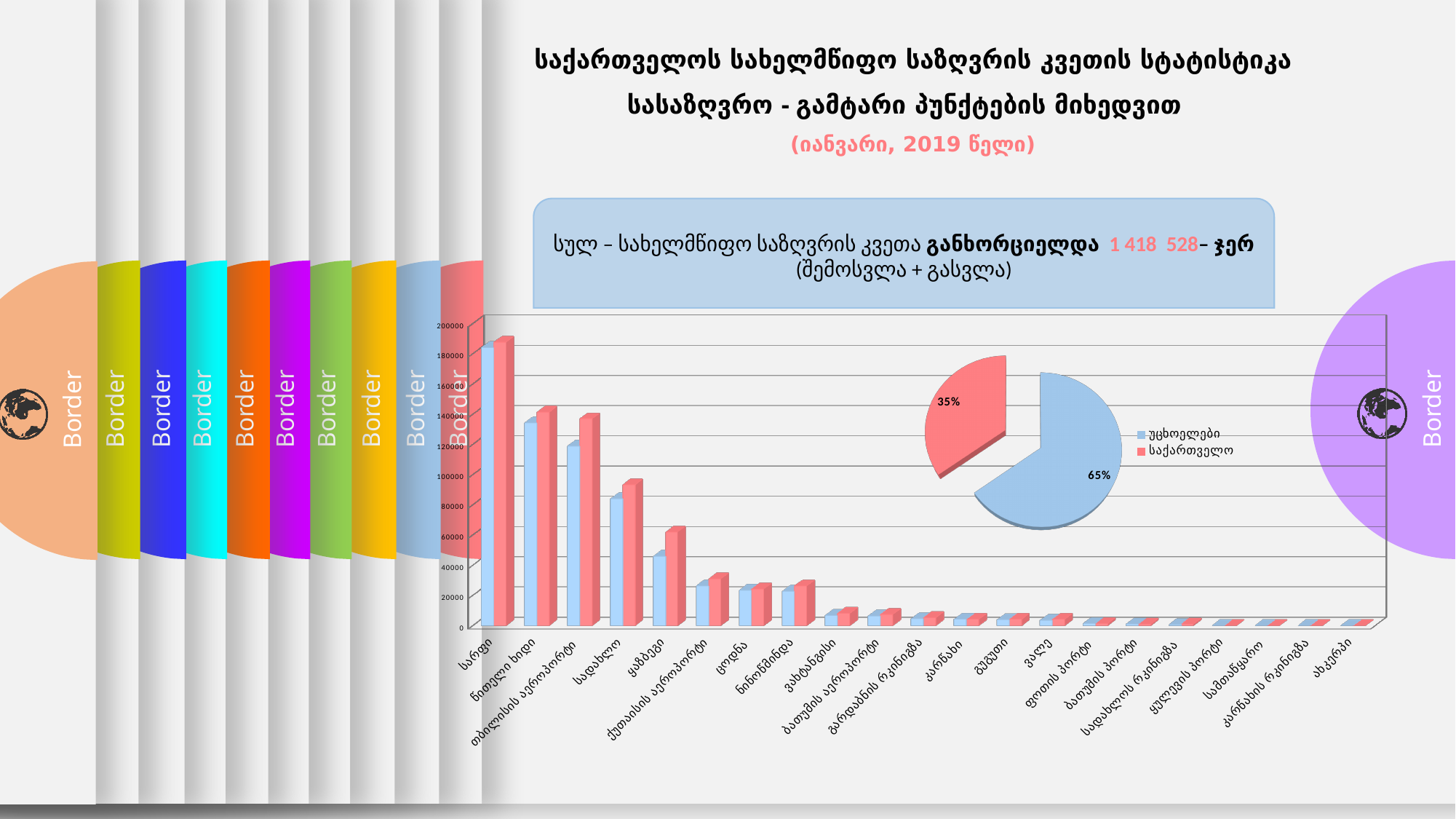
In the pie chart, what share is labelled for the red slice (საქართველო)? 35% In the bar chart, which category has the highest bars? სარფი In the bar chart, how many categories are shown on the x axis? 21 In the bar chart, is the blue bar for სადახლო greater or less than 100000? less What kind of chart is the large chart at the bottom with categories such as სარფი and წითელი ხიდი? bar chart In the pie chart, which slice is larger, უცხოელები or საქართველო? უცხოელები In the bar chart, do the bar heights generally rise or fall from left to right along the x axis? fall In the pie chart, what share is labelled for the blue slice (უცხოელები)? 65% What kind of chart is the chart on the right with the 35% and 65% labels? pie chart How many series does the legend of the pie chart list? 2 In the pie chart, what is the difference between the 65% slice and the 35% slice? 30% In the bar chart, is the red bar for სარფი greater or less than 160000? greater